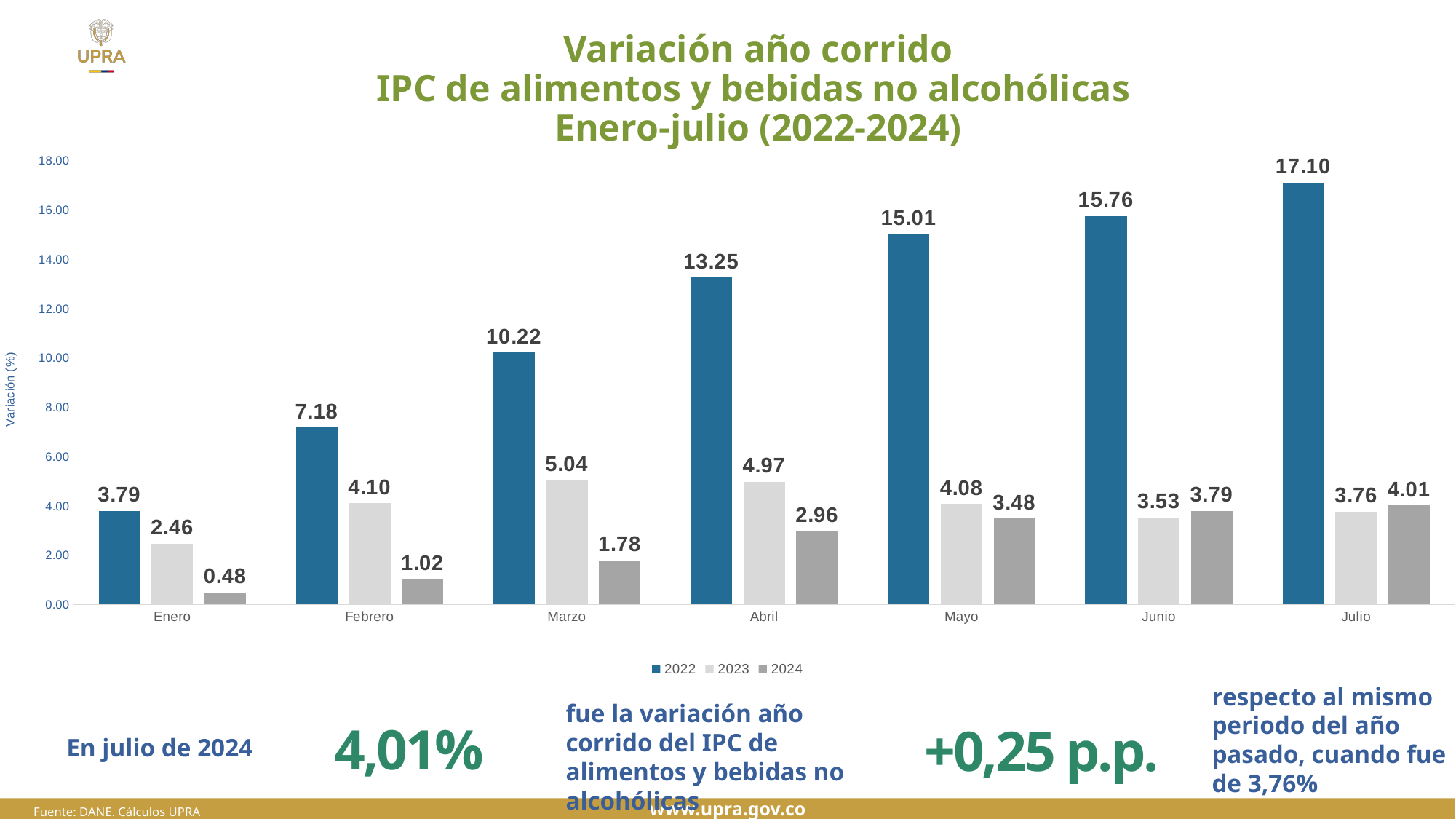
Do the 2022 values rise or fall from Enero to Julio? rise What is the difference between the 2024 and 2023 values in Julio? 0.25 What is the difference between the 2022 values in Julio and Enero? 13.31 Which month has the highest value for the 2023 series? Marzo Which is larger in Junio, the 2023 value or the 2024 value? 2024 How many series does the legend list? 3 Which month has the lowest value for the 2024 series? Enero How many months are shown on the x axis? 7 What is the value for 2023 in Marzo? 5.04 What is the value for 2022 in Julio? 17.10 What is the value for 2024 in Abril? 2.96 Is the value for 2022 in Abril greater or less than 12.00? greater